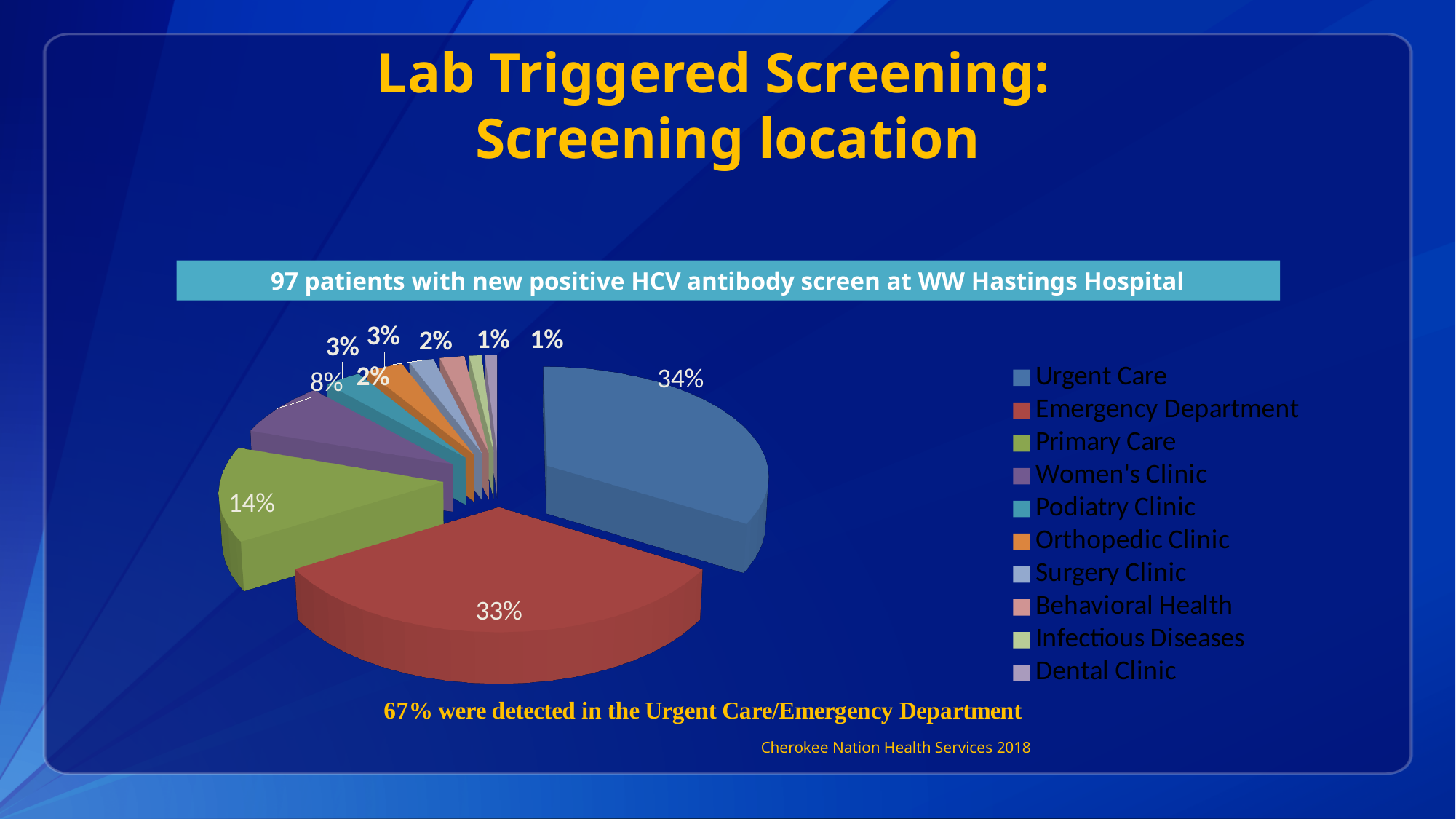
What is the combined share of Urgent Care and the Emergency Department? 67% What kind of chart is shown on the slide? pie chart What percentage of screenings were at the Emergency Department? 33% How many patients with a new positive HCV antibody screen does the chart cover? 97 Which has a larger share, Primary Care or the Women's Clinic? Primary Care What percentage of screenings were at Urgent Care? 34% Which screening location has the largest share of the pie? Urgent Care What percentage of screenings were at Primary Care? 14% What is the difference in percentage points between Urgent Care and Primary Care? 20% What percentage of screenings were at the Women's Clinic? 8% How many screening locations are shown in the pie chart? 10 What colour is the Emergency Department slice? red